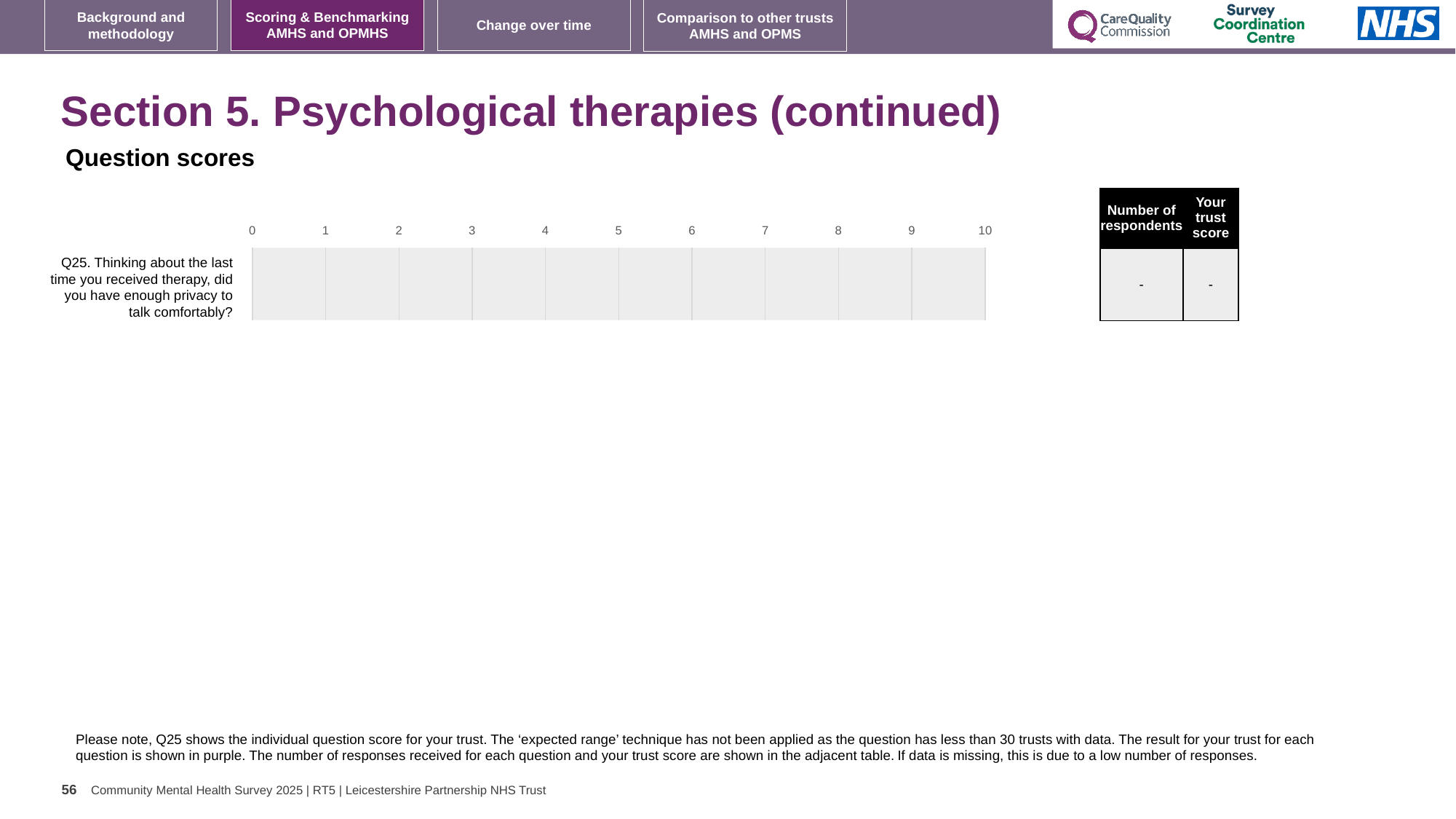
How many questions (categories) are shown on the chart? 1 What is the 'Number of respondents' value shown in the table for Q25? - What is the minimum value shown on the chart's horizontal axis? 0 Is a bar plotted for Q25 on the chart? No What is the 'Your trust score' value shown in the table for Q25? - Which question number is shown on the chart? Q25 What is the maximum value shown on the chart's horizontal axis? 10